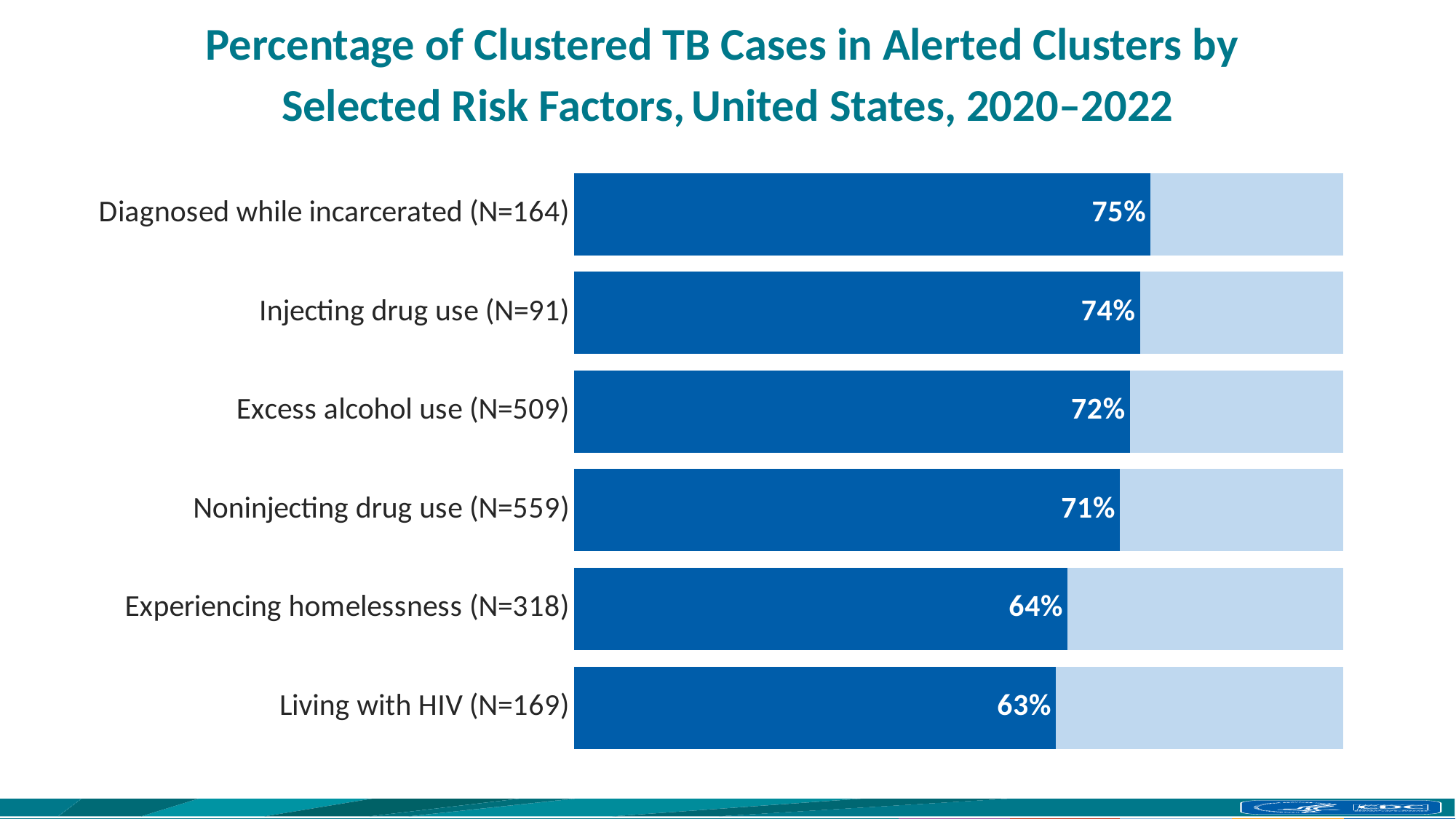
What is the N value shown for 'Noninjecting drug use'? 559 What percentage is shown for 'Living with HIV'? 63% What percentage is shown for 'Excess alcohol use'? 72% Which risk factor has the lowest percentage of clustered TB cases in alerted clusters? Living with HIV What percentage is shown for 'Experiencing homelessness'? 64% What is the difference in percentage points between 'Excess alcohol use' and 'Experiencing homelessness'? 8 What percentage of clustered TB cases were in alerted clusters for the 'Diagnosed while incarcerated' risk factor? 75% Which risk factor has the highest percentage of clustered TB cases in alerted clusters? Diagnosed while incarcerated What type of chart is shown on the slide? Bar chart Which has a higher percentage: 'Injecting drug use' or 'Noninjecting drug use'? Injecting drug use How many risk factor categories are shown in the chart? 6 What is the difference in percentage points between 'Diagnosed while incarcerated' and 'Living with HIV'? 12